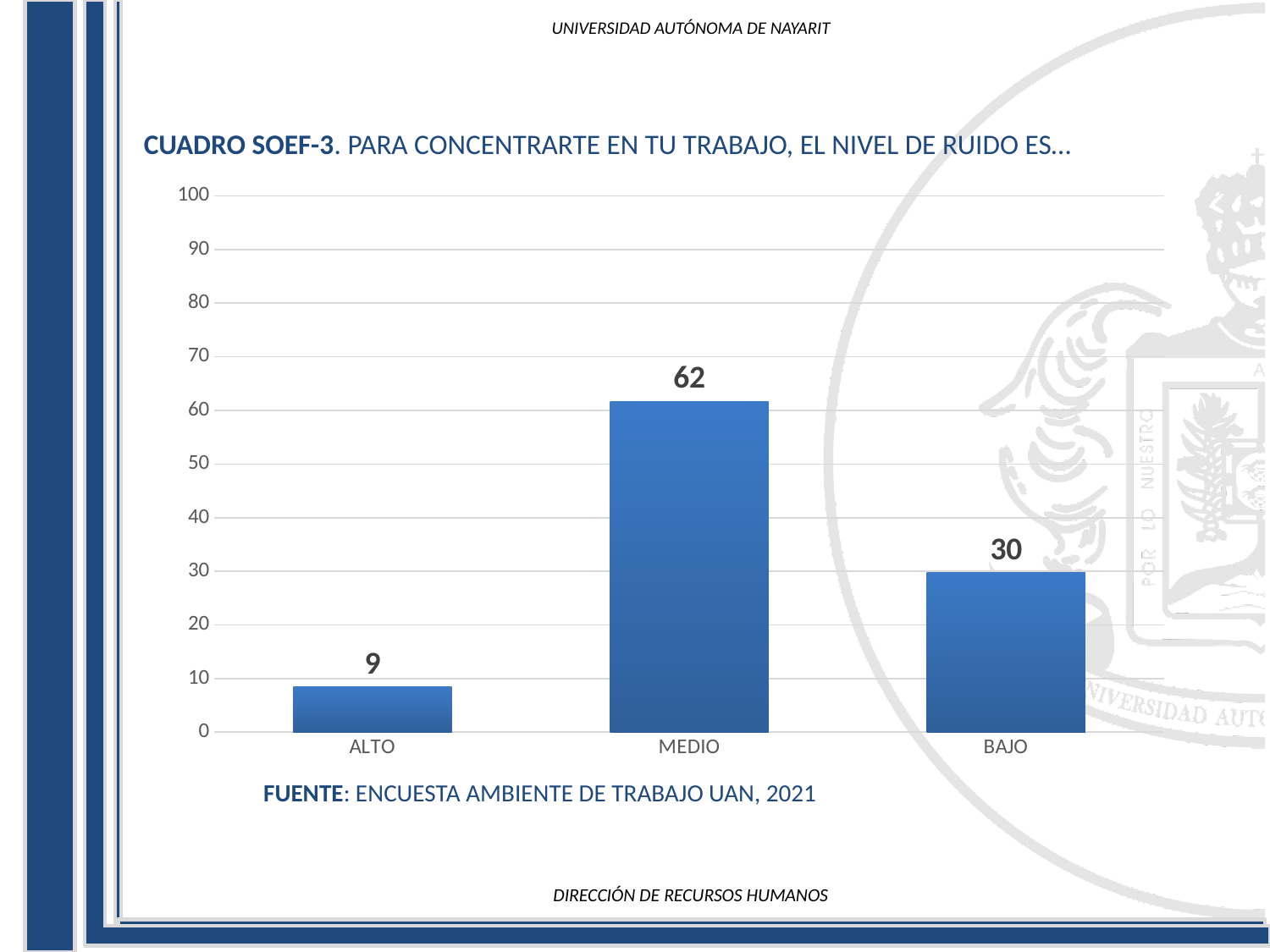
How many categories are shown on the x axis? 3 What kind of chart is shown on the slide? bar chart What is the value for MEDIO? 62 Which category has the lowest value? ALTO Is the value for MEDIO greater or less than 50? greater What is the value for ALTO? 9 Which category has the highest value? MEDIO What is the difference between the values for BAJO and ALTO? 21 What source is cited below the chart? ENCUESTA AMBIENTE DE TRABAJO UAN, 2021 Which is larger, the value for BAJO or the value for ALTO? BAJO What is the difference between the values for MEDIO and BAJO? 32 What is the value for BAJO? 30